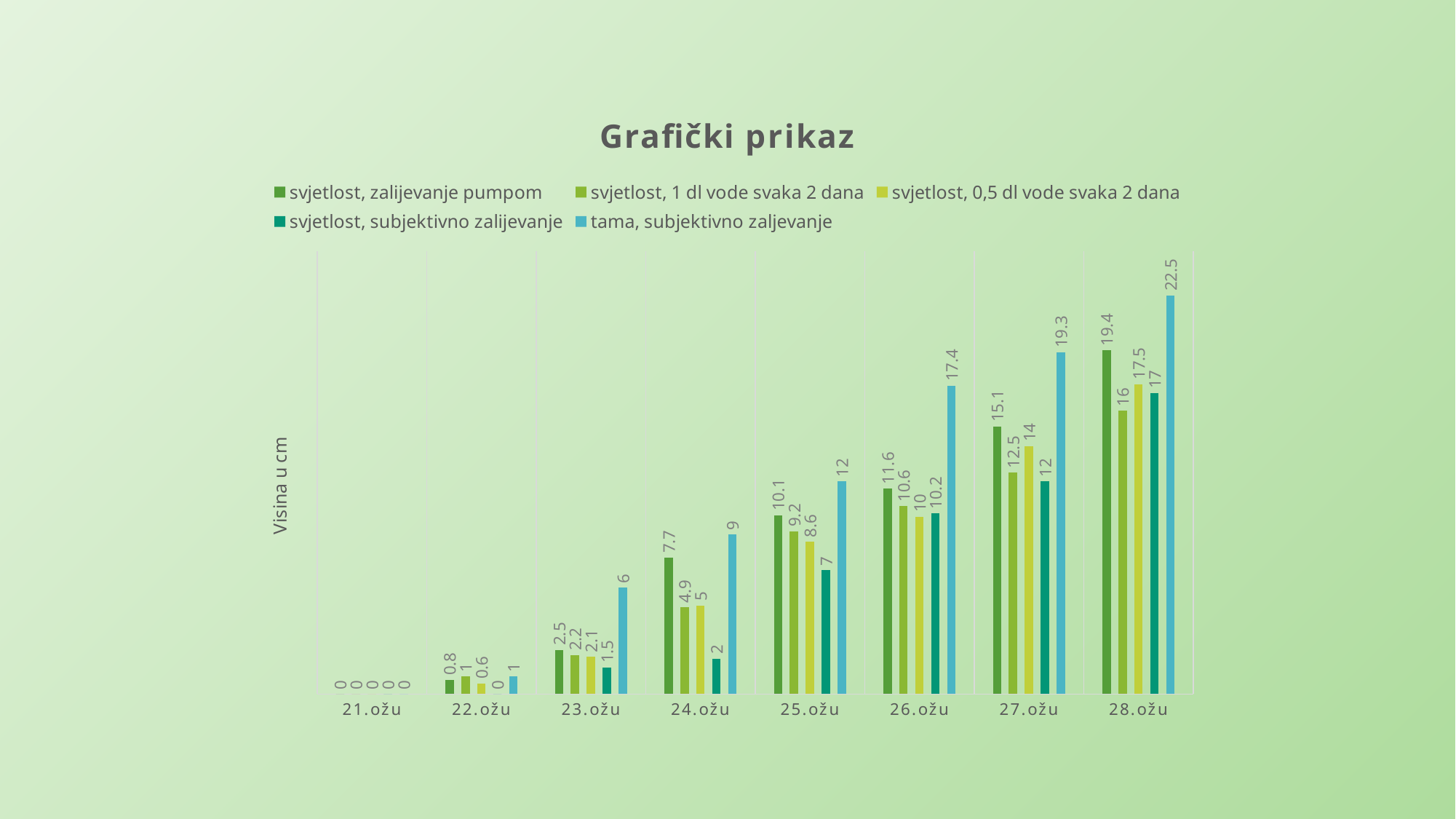
What is the value for 'svjetlost, zalijevanje pumpom' on 24.ožu? 7.7 How many date categories are shown on the x axis? 8 What is the value for 'tama, subjektivno zaljevanje' on 28.ožu? 22.5 On 28.ožu, which is larger: 'svjetlost, 1 dl vode svaka 2 dana' or 'svjetlost, 0,5 dl vode svaka 2 dana'? svjetlost, 0,5 dl vode svaka 2 dana What is the difference between 'tama, subjektivno zaljevanje' and 'svjetlost, zalijevanje pumpom' on 26.ožu? 5.8 What type of chart is shown on the slide? bar chart Do the values for 'tama, subjektivno zaljevanje' rise or fall from 21.ožu to 28.ožu? rise How many series does the legend list? 5 What is the title of the chart? Grafički prikaz What is the value for 'svjetlost, subjektivno zalijevanje' on 25.ožu? 7 Which series has the lowest value on 24.ožu? svjetlost, subjektivno zalijevanje Which series has the highest value on 27.ožu? tama, subjektivno zaljevanje